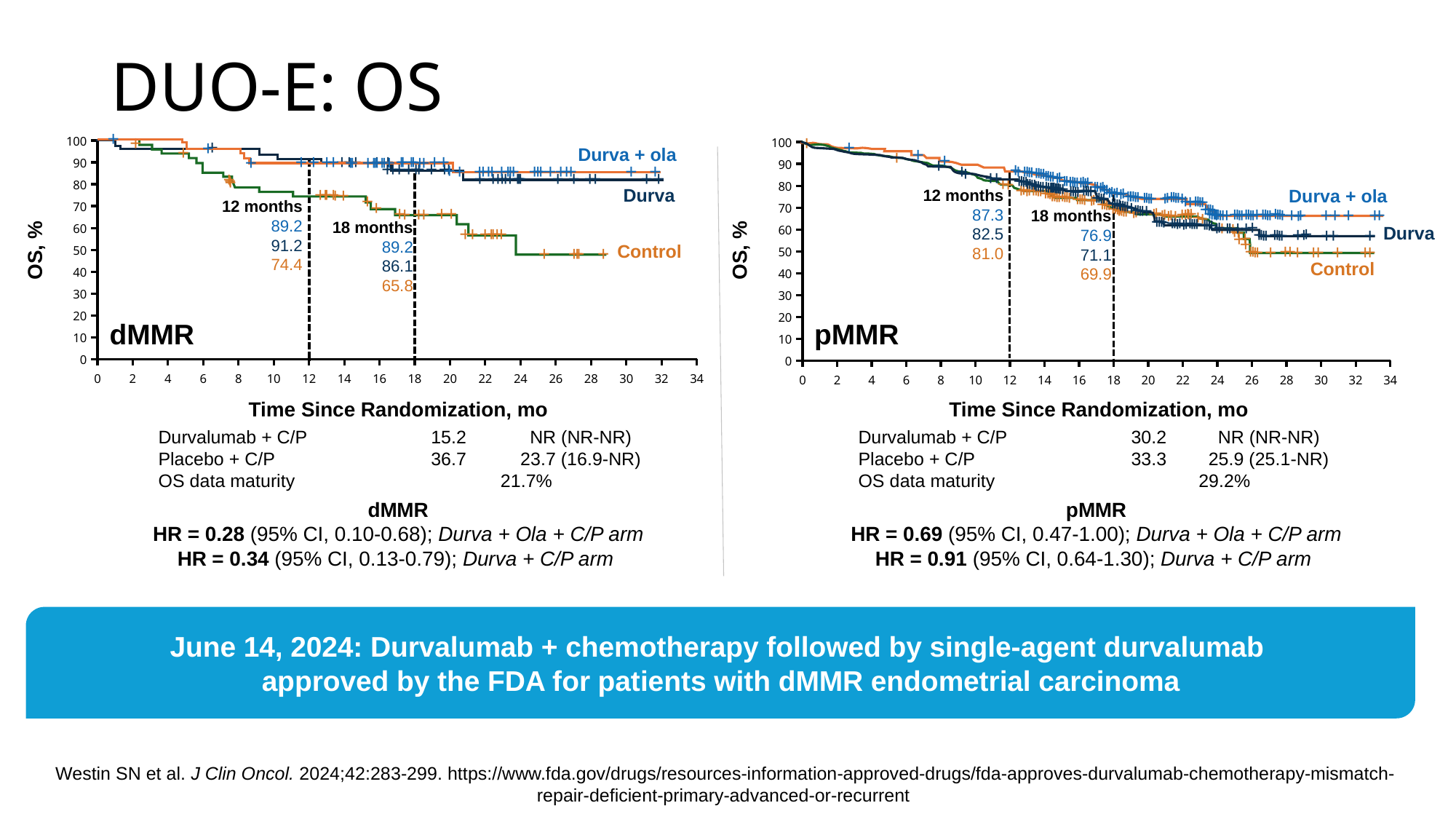
In the pMMR chart, is the OS value for Durva + ola at 18 months greater or less than 80? less In the pMMR chart, what is the difference between the Durva + ola and Durva OS values at 12 months? 4.8 How many treatment arms are plotted in the pMMR chart? 3 In the pMMR chart, which arm has the lowest OS value at 18 months? Control In the dMMR chart, do the OS curves rise or fall as time since randomization increases? fall In the pMMR chart, what is the OS value for the Control arm at 18 months? 69.9 In the dMMR chart, which arm has the highest OS value at 12 months? Durva In the dMMR chart, which is larger at 18 months: the OS value for Durva or for Control? Durva In the dMMR chart, what is the difference between the Durva + ola and Control OS values at 18 months? 23.4 In the dMMR chart, what is the OS value for the Durva + ola arm at 18 months? 89.2 In the dMMR chart, what is the OS value for the Control arm at 12 months? 74.4 In the pMMR chart, what is the OS value for the Durva arm at 12 months? 82.5